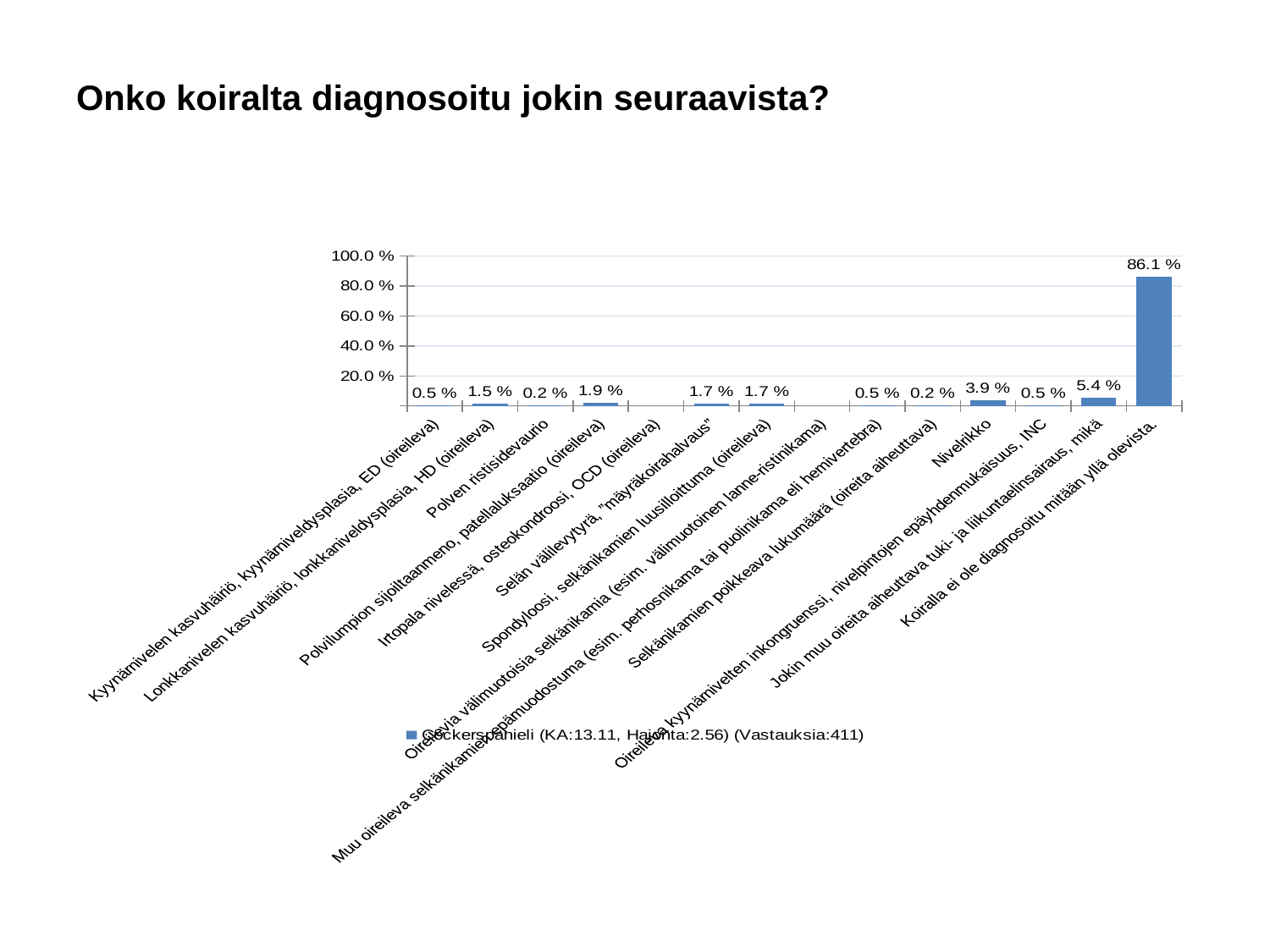
What is the value for "Koiralla ei ole diagnosoitu mitään yllä olevista."? 86.1 % Which is larger, the value for Nivelrikko or the value for "Jokin muu oireita aiheuttava tuki- ja liikuntaelinsairaus, mikä"? Jokin muu oireita aiheuttava tuki- ja liikuntaelinsairaus, mikä How many categories are shown on the x axis? 14 What kind of chart is shown on the slide? bar chart What is the value for "Lonkkanivelen kasvuhäiriö, lonkkaniveldysplasia, HD (oireileva)"? 1.5 % What is the difference between the value for "Koiralla ei ole diagnosoitu mitään yllä olevista." and the value for "Jokin muu oireita aiheuttava tuki- ja liikuntaelinsairaus, mikä"? 80.7 % How many series does the legend list? 1 What is the value for Polven ristisidevaurio? 0.2 % What is the value for Nivelrikko? 3.9 % Is the value for "Koiralla ei ole diagnosoitu mitään yllä olevista." greater or less than 80.0 %? greater Which category has the highest value? Koiralla ei ole diagnosoitu mitään yllä olevista. What is the value for "Jokin muu oireita aiheuttava tuki- ja liikuntaelinsairaus, mikä"? 5.4 %